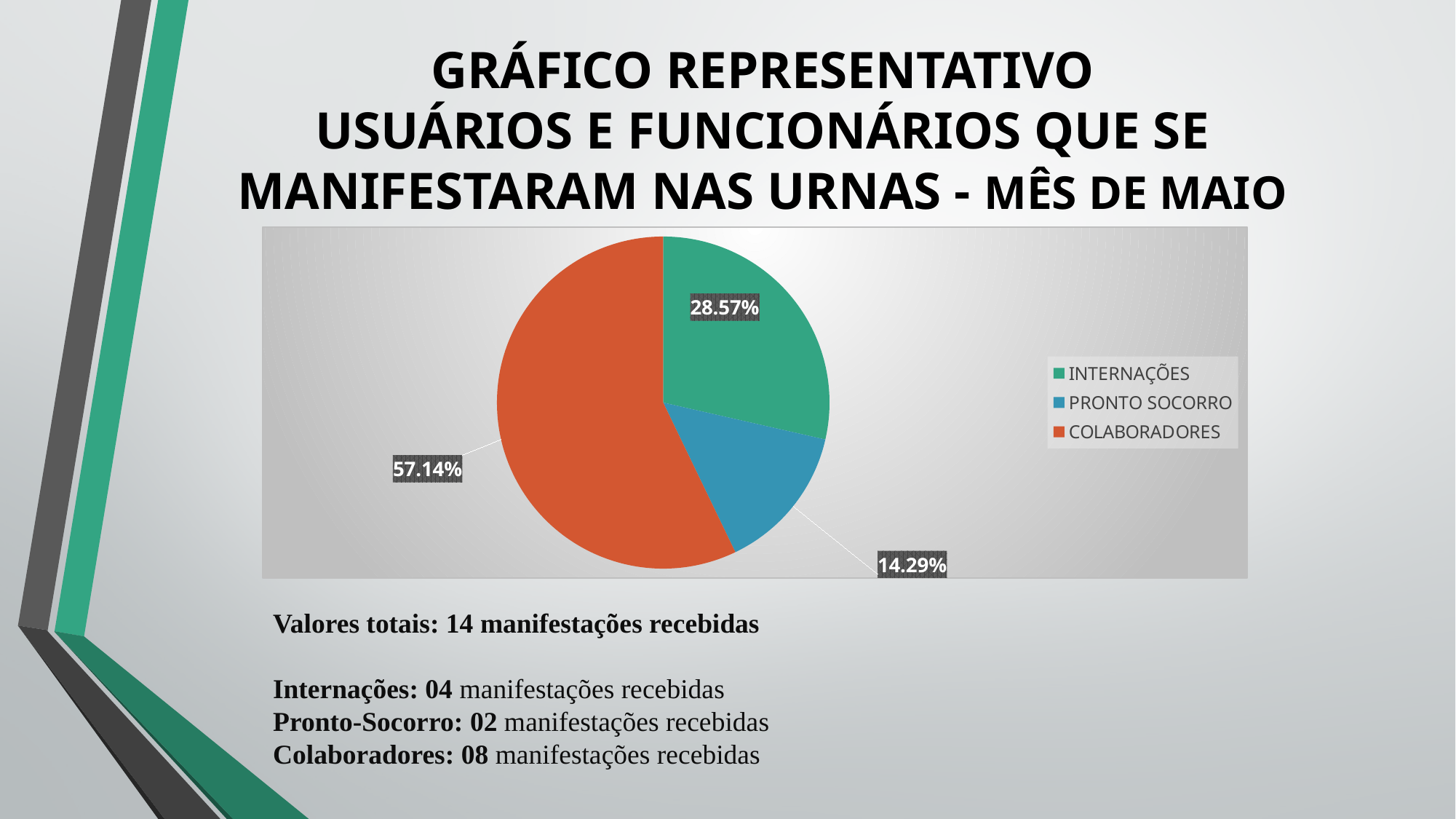
What kind of chart is shown on the slide? pie chart Which category has the smallest slice of the pie? PRONTO SOCORRO What colour is the COLABORADORES slice in the pie chart? orange What percentage of the pie does the PRONTO SOCORRO slice represent? 14.29% What percentage of the pie does the INTERNAÇÕES slice represent? 28.57% How many slices does the pie chart have? 3 What is the difference in percentage points between the COLABORADORES slice and the INTERNAÇÕES slice? 28.57% Which category has the largest slice of the pie? COLABORADORES How many entries does the legend list? 3 Is the share of the COLABORADORES slice greater or less than 50%? greater Which slice is larger, INTERNAÇÕES or PRONTO SOCORRO? INTERNAÇÕES What percentage of the pie does the COLABORADORES slice represent? 57.14%